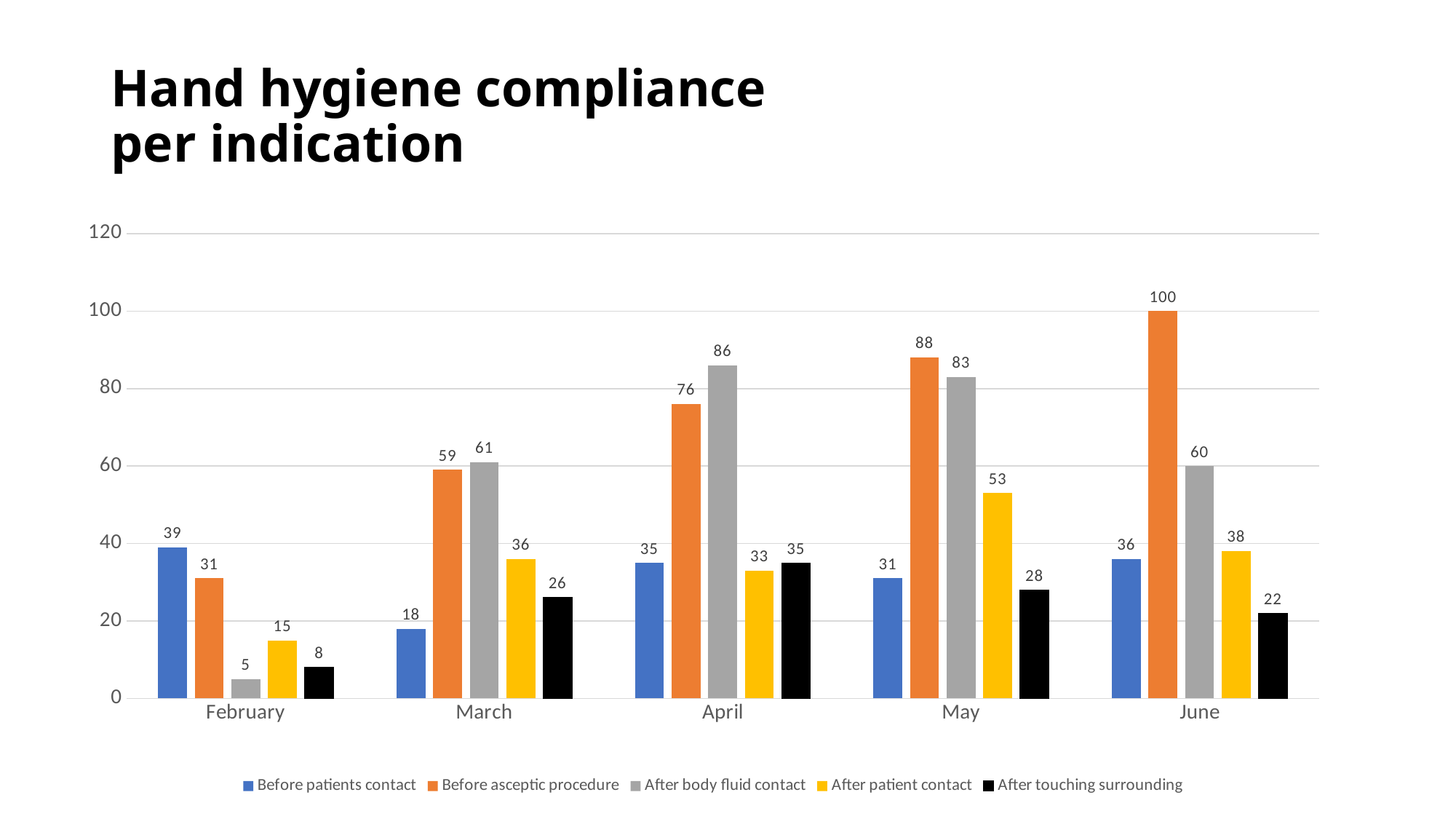
What is the difference between After body fluid contact in April and in March? 25 Is the value for After touching surrounding in March greater or less than 40? less What is the value for After body fluid contact in February? 5 Which month has the lowest value for Before patients contact? March What is the value for Before asceptic procedure in June? 100 What is the title of the chart on the slide? Hand hygiene compliance per indication How many series does the legend list? 5 What kind of chart is shown on the slide? Bar chart What is the value for After patient contact in May? 53 Which is larger in May: Before asceptic procedure or After body fluid contact? Before asceptic procedure Which month has the highest value for Before asceptic procedure? June How many months are shown on the x axis? 5